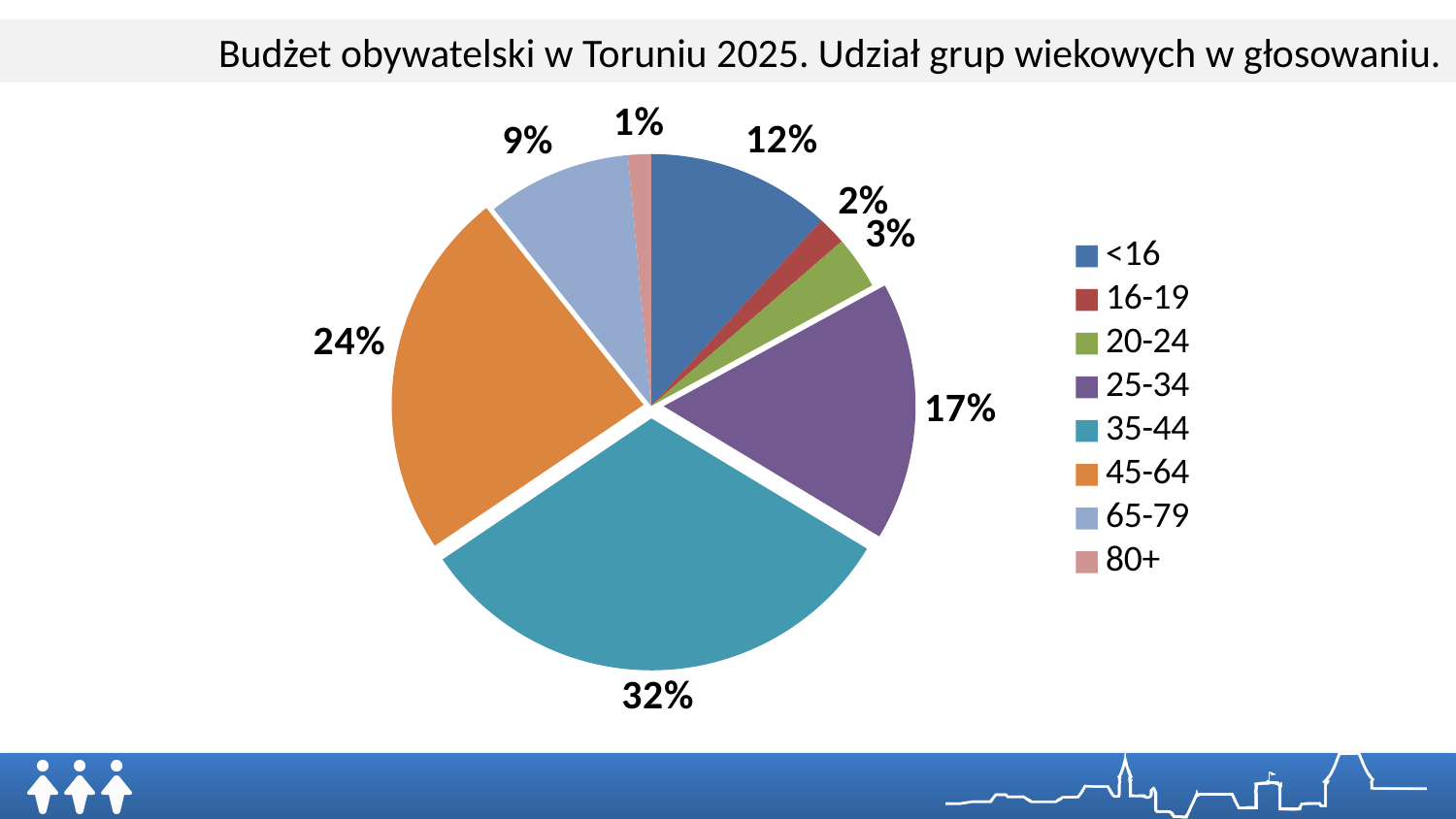
Which age group has a larger share, 25-34 or 65-79? 25-34 Which age group has the smallest share of the vote? 80+ What is the title of the chart? Budżet obywatelski w Toruniu 2025. Udział grup wiekowych w głosowaniu. What is the combined share of the 16-19 and 20-24 age groups? 5% What share of the vote does the 80+ age group have? 1% How many age groups are shown in the pie chart? 8 What type of chart is shown on the slide? Pie chart Which age group has the largest share of the vote? 35-44 What share of the vote does the 35-44 age group have? 32% What share of the vote does the 45-64 age group have? 24% What share of the vote does the <16 age group have? 12% What is the difference in percentage points between the 35-44 and 45-64 age groups? 8